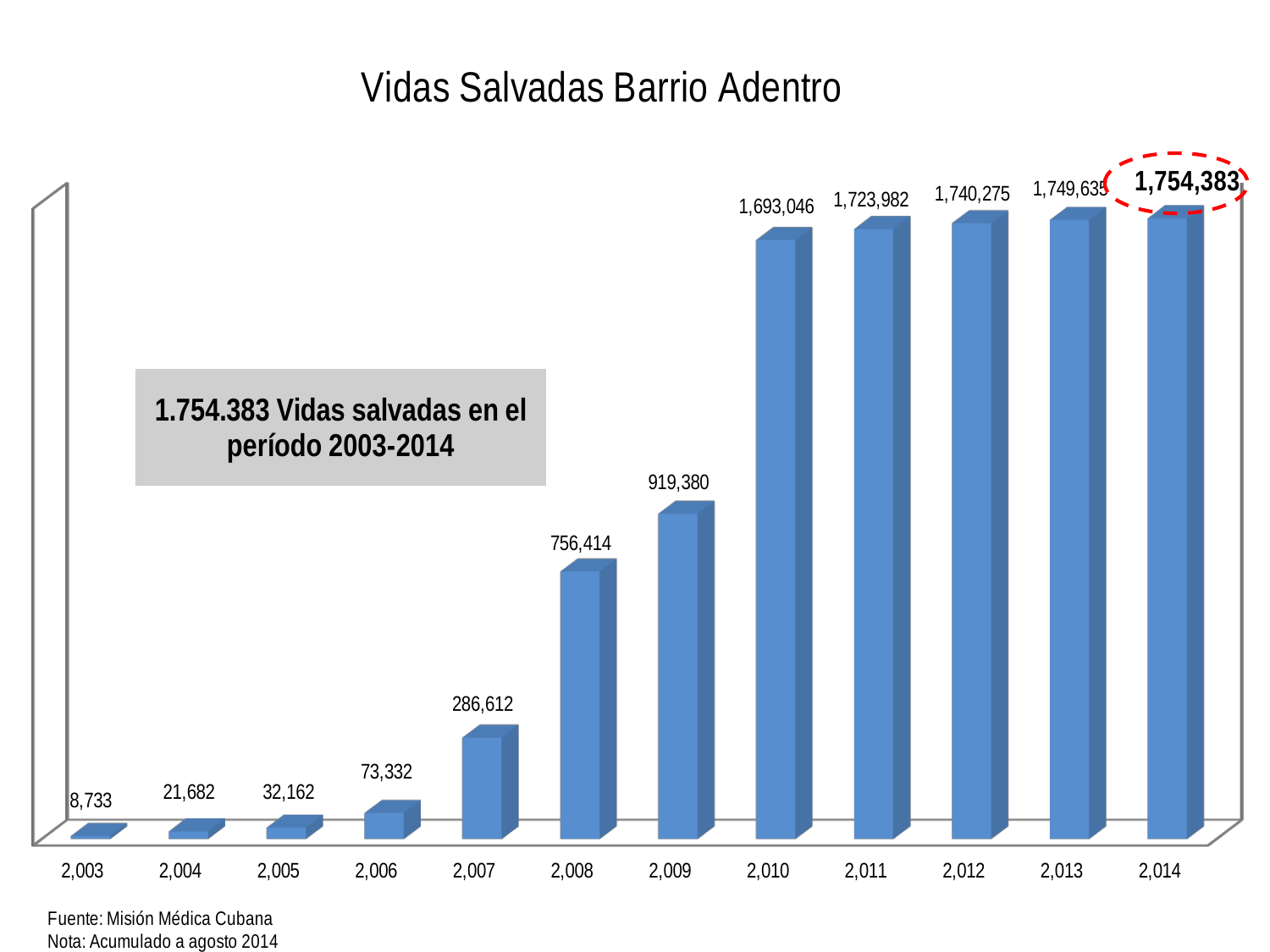
Do the values rise or fall from 2,003 to 2,014? rise What is the title of the chart? Vidas Salvadas Barrio Adentro What is the difference between the values for 2,009 and 2,008? 162,966 How many bars (years) are plotted in the chart? 12 What is the value shown for 2,007? 286,612 Which is larger, the value for 2,006 or the value for 2,007? 2,007 Which year has the lowest value? 2,003 Which year has the highest value? 2,014 What is the value shown for 2,011? 1,723,982 What is the value shown for 2,008? 756,414 What type of chart is shown on the slide? bar chart What is the value shown for 2,003? 8,733